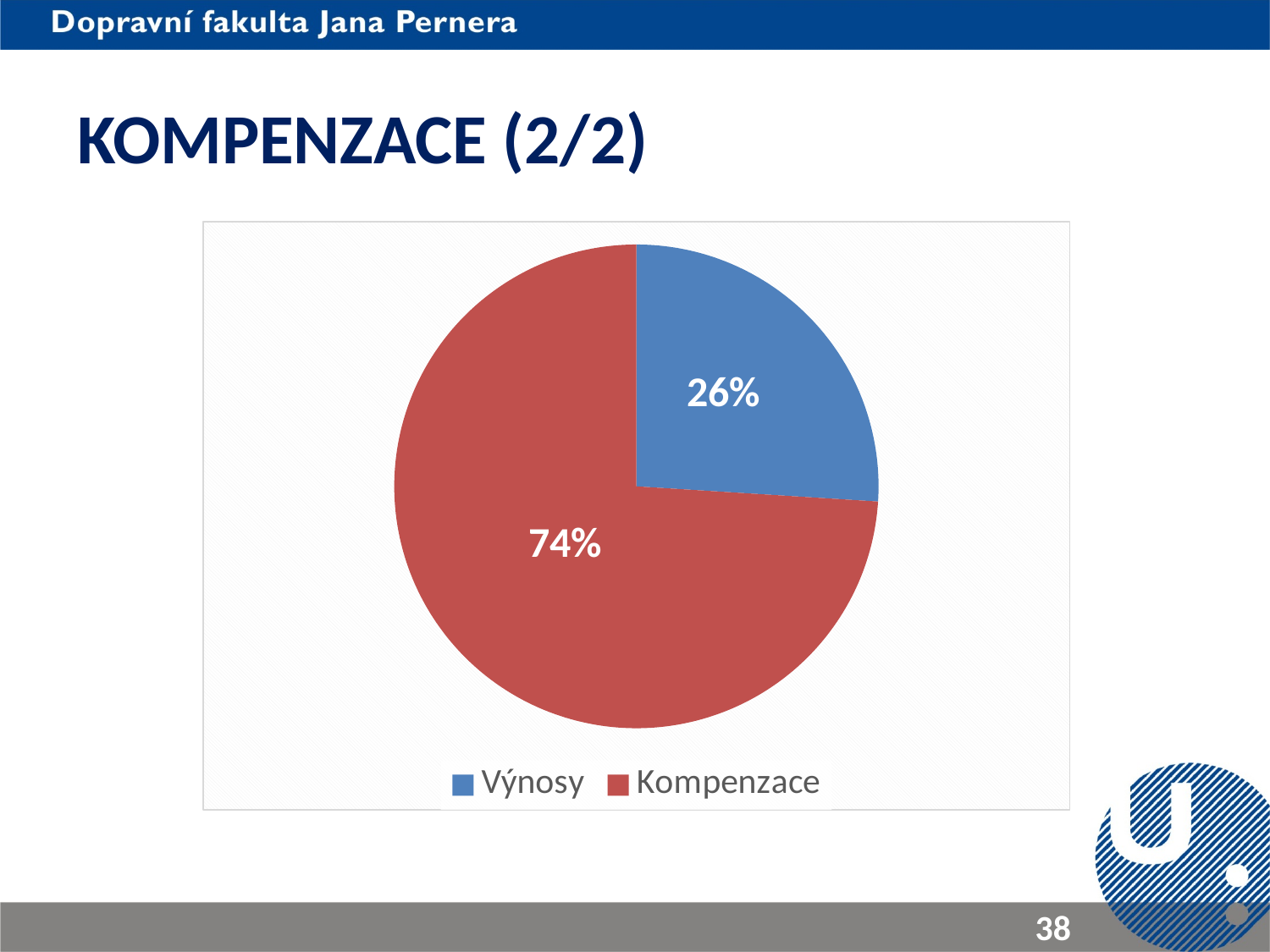
What share of the pie does Kompenzace represent? 74% What share of the pie does Výnosy represent? 26% What is the difference in percentage points between the Kompenzace and Výnosy slices? 48 What kind of chart is shown on the slide? pie chart What colour is the Kompenzace slice? red Which slice of the pie is the largest? Kompenzace What colour is the Výnosy slice? blue How many entries does the legend list? 2 Which is larger, the Výnosy slice or the Kompenzace slice? Kompenzace Which slice of the pie is the smallest? Výnosy How many slices does the pie chart have? 2